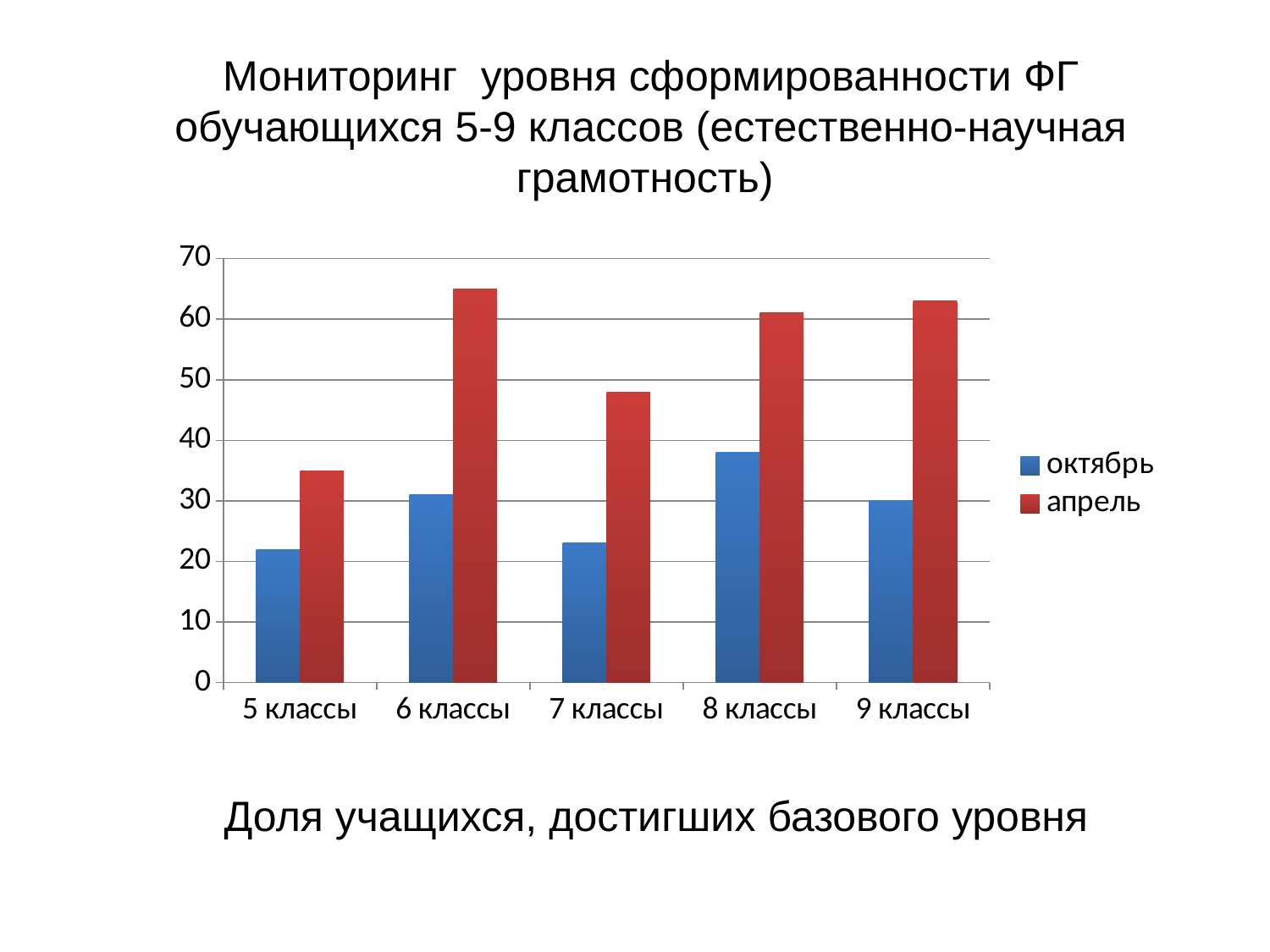
How many series does the legend list? 2 How many class groups are shown on the x axis? 5 What kind of chart is shown on the slide? bar chart Which class group has the highest value for октябрь? 8 классы Is the value for 5 классы in октябрь greater or less than 30? less Is the value for 8 классы in октябрь greater or less than 40? less Which colour represents the апрель series in the legend? red Which is larger for октябрь: 8 классы or 6 классы? 8 классы Is the value for 6 классы in апрель greater or less than 60? greater Which class group has the lowest value for апрель? 5 классы Which is larger for апрель: 7 классы or 8 классы? 8 классы